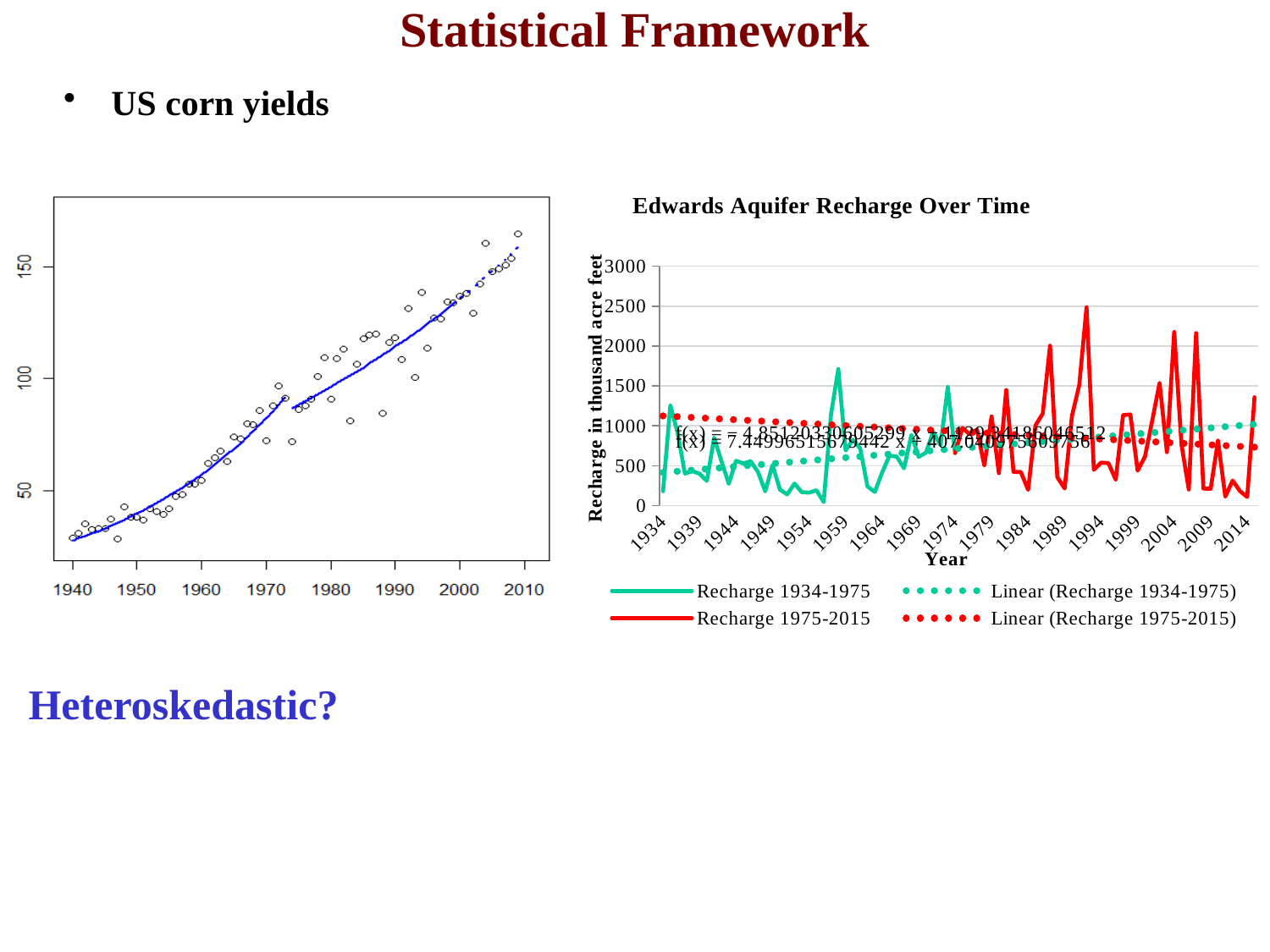
In the Edwards Aquifer Recharge Over Time chart, is the peak of the Recharge 1934-1975 series around 1958 greater or less than 1500? greater What kind of chart is the US corn yields chart on the left side of the slide? Scatter plot What kind of chart is the Edwards Aquifer Recharge Over Time chart? Line chart How many entries does the legend of the Edwards Aquifer Recharge Over Time chart list? 4 In the Edwards Aquifer Recharge Over Time chart, is the highest peak of the Recharge 1975-2015 series (around 1992) greater or less than 2000? greater In the US corn yields chart on the left, do the plotted values generally rise or fall from 1940 to 2010? Rise In the Edwards Aquifer Recharge Over Time chart, does the dotted Linear (Recharge 1975-2015) trendline rise or fall from left to right? Fall How many year labels are shown on the x axis of the Edwards Aquifer Recharge Over Time chart? 17 In the Edwards Aquifer Recharge Over Time chart, does the dotted Linear (Recharge 1934-1975) trendline rise or fall from left to right? Rise In the Edwards Aquifer Recharge Over Time chart, what is the label on the vertical axis? Recharge in thousand acre feet What is the title of the chart on the right side of the slide? Edwards Aquifer Recharge Over Time In the Edwards Aquifer Recharge Over Time chart, which series reaches the higher peak value, Recharge 1934-1975 or Recharge 1975-2015? Recharge 1975-2015